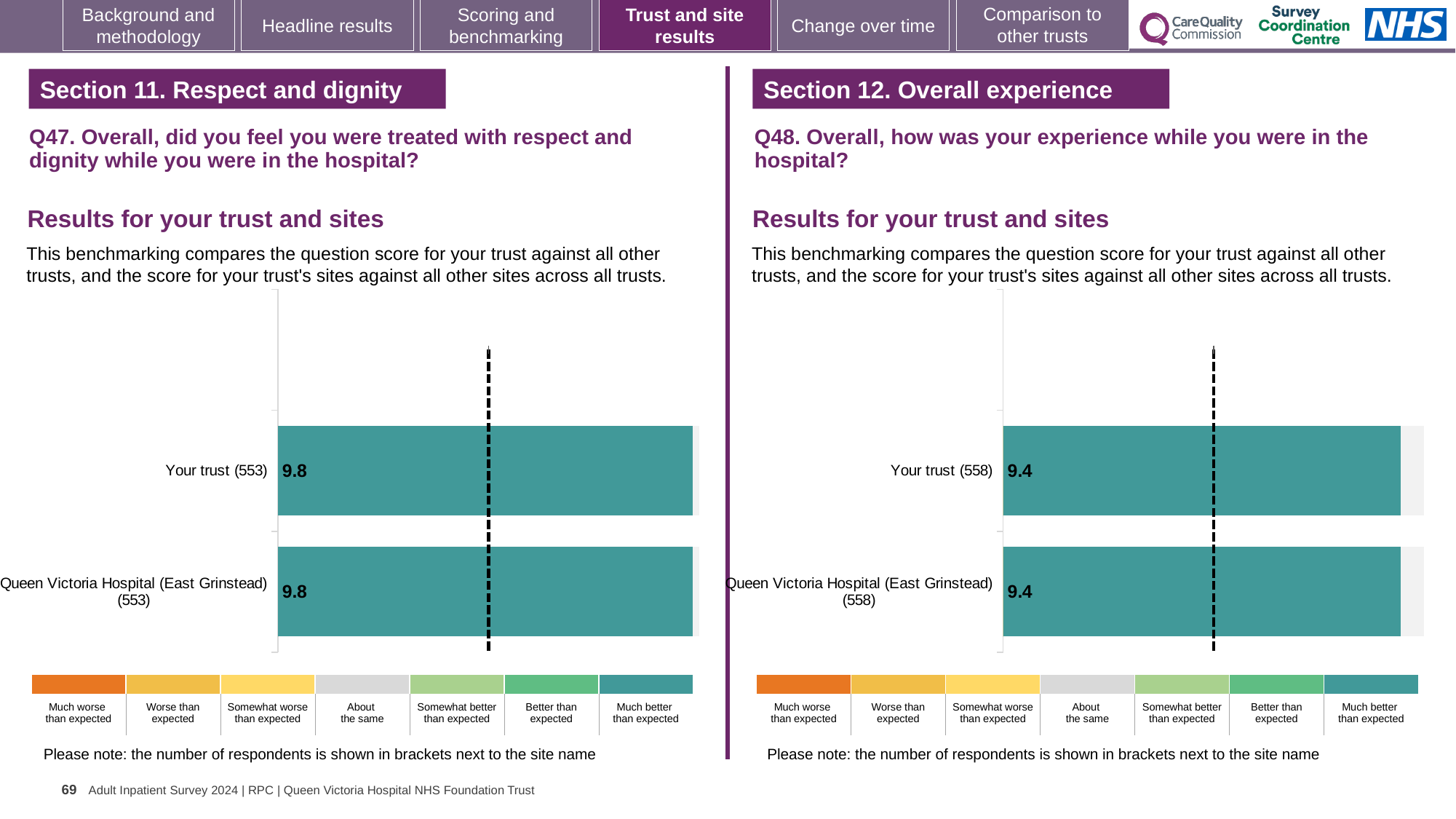
What kind of chart is the Q47 chart on the left? Bar chart In the Q47 chart on the left, what is the score for Queen Victoria Hospital (East Grinstead)? 9.8 In the Q47 chart on the left, what is the score for Your trust? 9.8 In the Q48 chart on the right, what is the score for Your trust? 9.4 Which is larger: the Your trust score in the Q47 chart on the left or the Your trust score in the Q48 chart on the right? Q47 chart (9.8) In the Q48 chart on the right, which benchmark category does the colour of the bars correspond to in the key below? Much better than expected In the Q48 chart on the right, what is the score for Queen Victoria Hospital (East Grinstead)? 9.4 In the Q47 chart on the left, how many respondents are shown in brackets for Your trust? 553 How many benchmark categories are shown in the colour key below the Q47 chart on the left? 7 In the Q48 chart on the right, how many respondents are shown in brackets for Queen Victoria Hospital (East Grinstead)? 558 How many bars are plotted in the Q48 chart on the right? 2 In the Q47 chart on the left, what is the difference between the score for Your trust and the score for Queen Victoria Hospital (East Grinstead)? 0